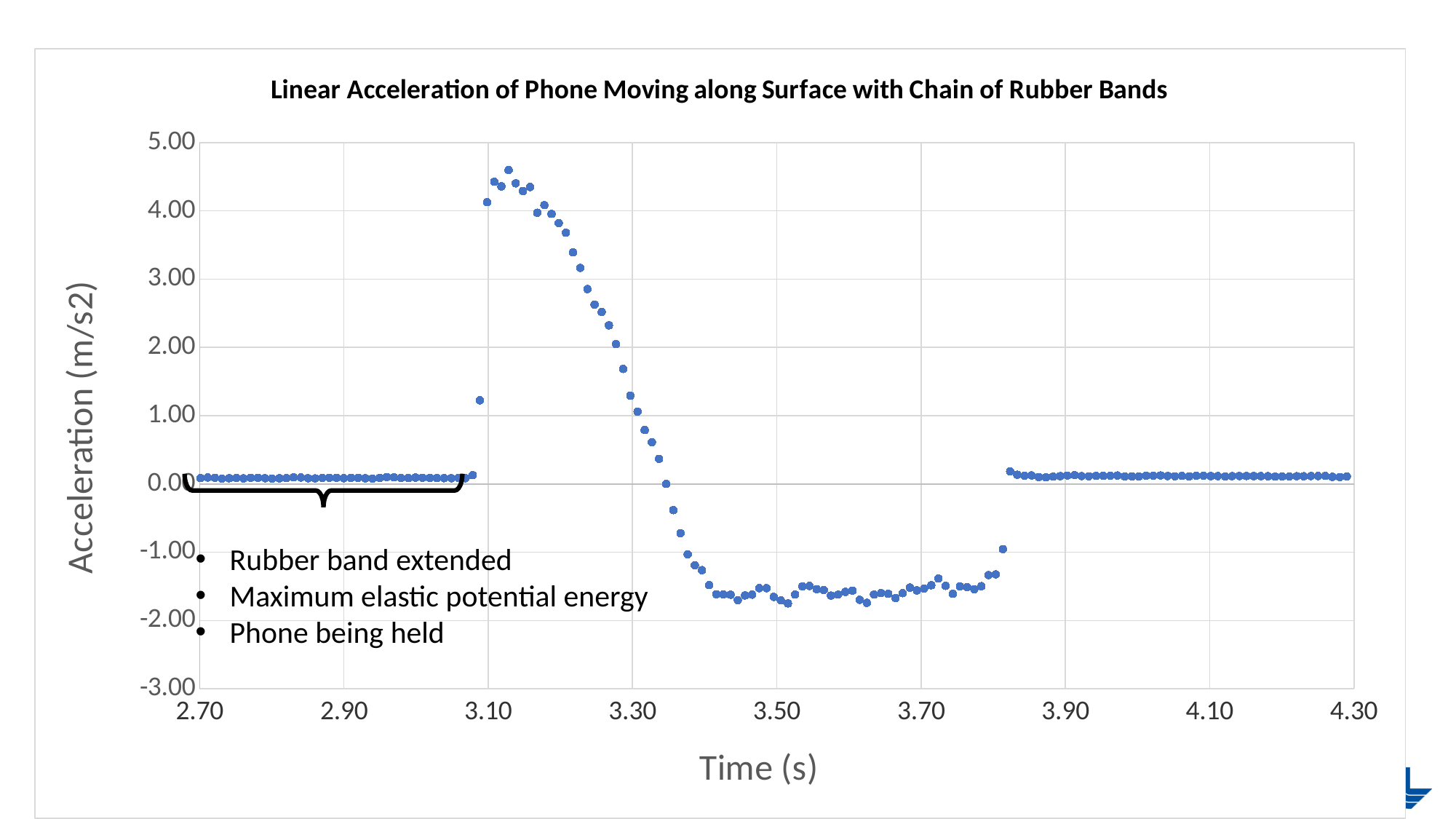
What is the title of the chart? Linear Acceleration of Phone Moving along Surface with Chain of Rubber Bands Is the acceleration at time 4.10 s greater or less than 1.00? less Is the acceleration at time 2.90 s greater or less than 1.00? less Between time 3.10 s and 3.40 s, does the acceleration rise or fall? fall Is the acceleration at time 2.80 s larger or smaller than the acceleration at time 3.50 s? larger What is the label of the vertical axis? Acceleration (m/s2) Is the acceleration at time 3.20 s larger or smaller than the acceleration at time 3.60 s? larger Is the lowest acceleration value plotted greater or less than -1.00? less What kind of chart is shown on the slide? scatter chart